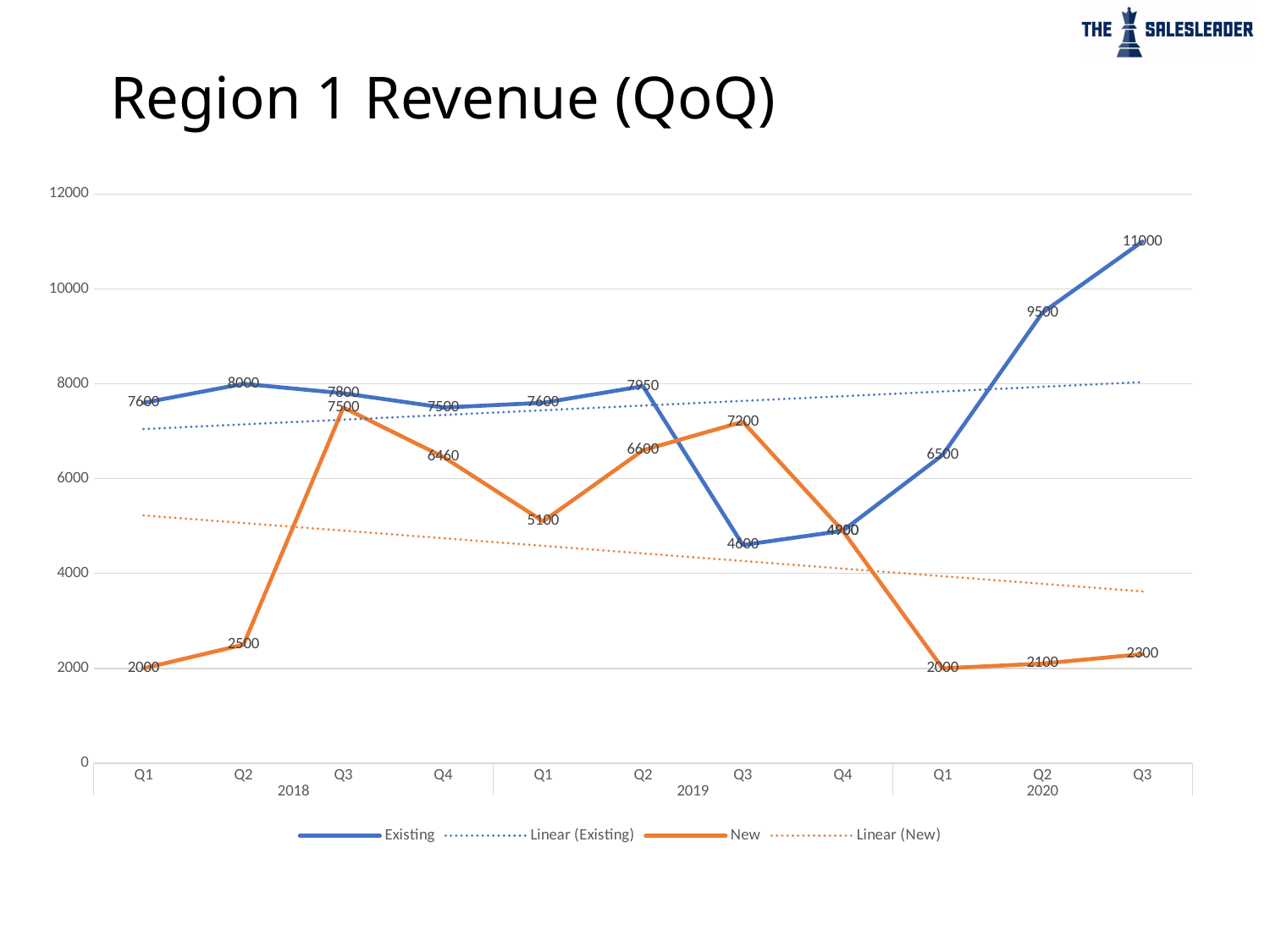
Does the Existing revenue rise or fall from Q3 2019 to Q3 2020? Rise What kind of chart is shown on the slide? Line chart How many entries does the legend list? 4 What is the New revenue value for Q4 2018? 6460 In Q3 2019, which series has the larger value, Existing or New? New In which quarter is the Existing revenue highest? Q3 2020 In which quarter is the Existing revenue lowest? Q3 2019 How many quarters are plotted on the x axis? 11 In which quarter is the New revenue highest? Q3 2018 What is the New revenue value for Q3 2018? 7500 What is the Existing revenue value for Q3 2020? 11000 What is the difference between the Existing revenue in Q3 2020 and Q2 2020? 1500